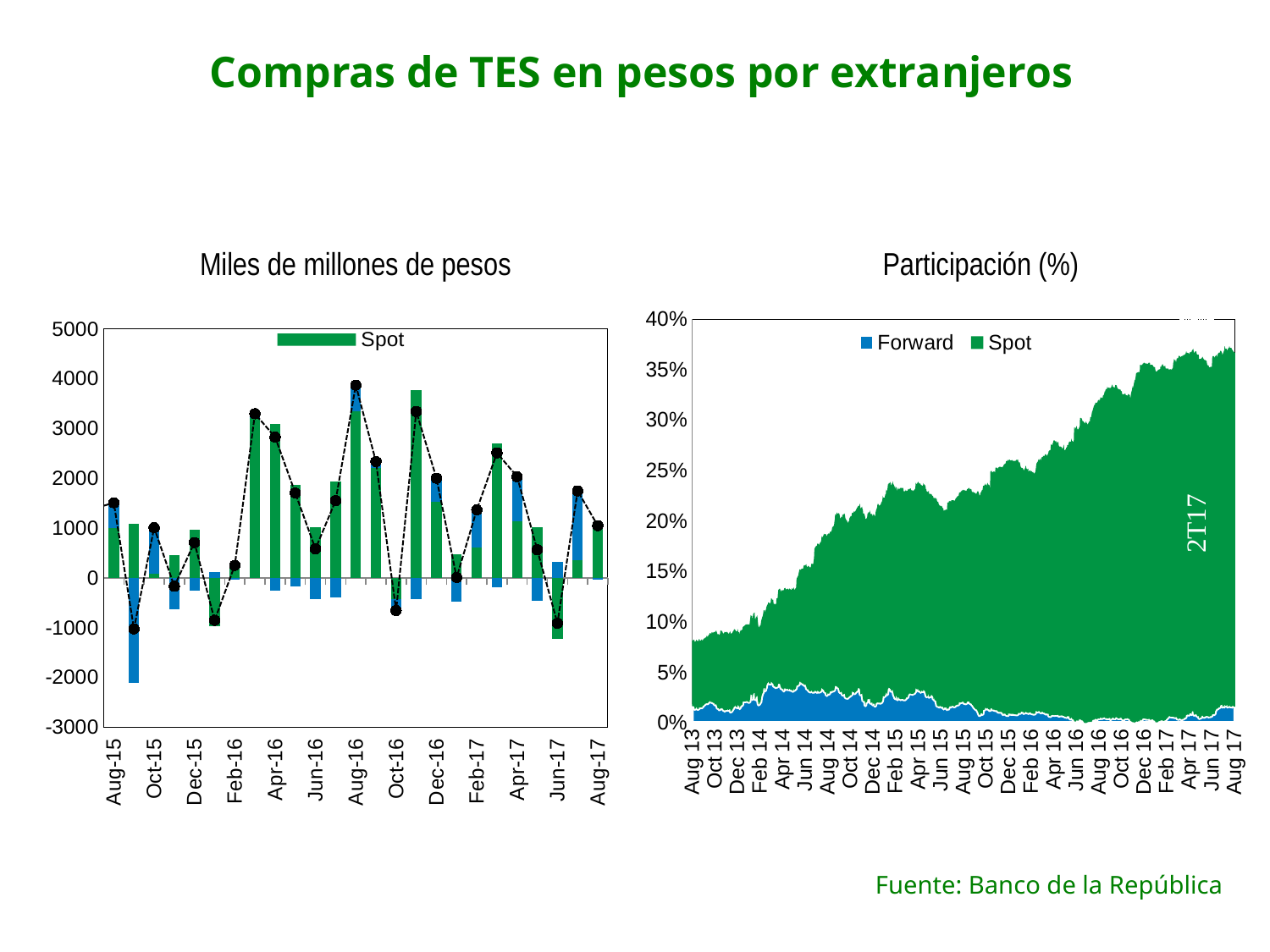
In the left chart "Miles de millones de pesos", is the value of the dashed line for Oct-16 greater or less than 0? less In the right chart "Participación (%)", how many series does the legend list? 2 In the left chart "Miles de millones de pesos", how many series does the legend list? 1 What kind of chart is the right chart titled "Participación (%)"? area chart In the left chart "Miles de millones de pesos", is the value of the dashed line for Jun-16 greater or less than 1000? less In the left chart "Miles de millones de pesos", which labeled month has the highest value on the dashed line? Aug-16 In the right chart "Participación (%)", is the total participation at Aug 17 greater or less than 35%? greater In the left chart "Miles de millones de pesos", is the dashed-line value larger for Aug-16 or for Apr-16? Aug-16 In the right chart "Participación (%)", what are the two series named in the legend? Forward and Spot What kind of chart is the left chart titled "Miles de millones de pesos"? bar chart In the right chart "Participación (%)", does the total participation generally rise or fall from Aug 13 to Aug 17? rise